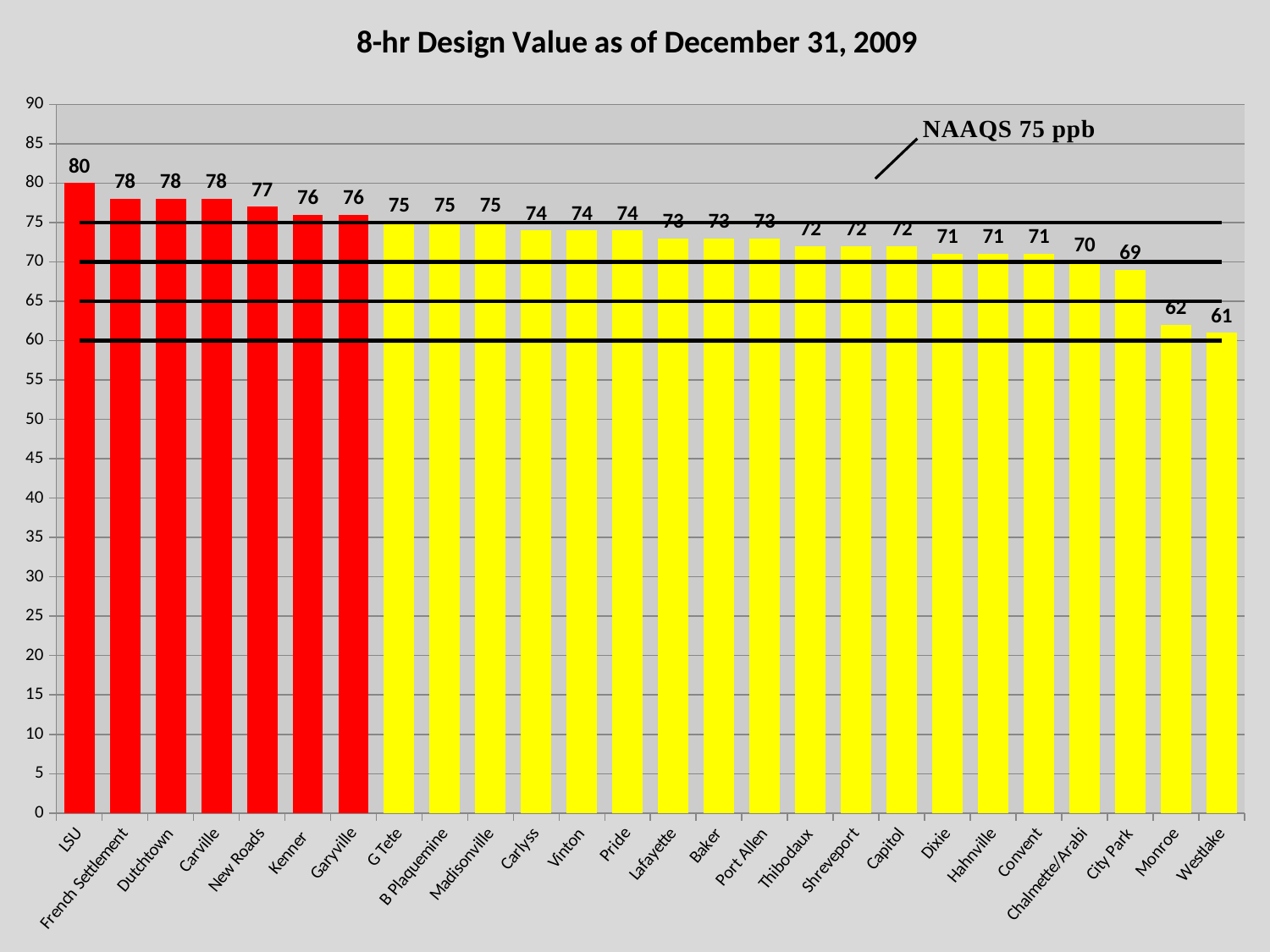
What standard value is labelled by the annotation on the chart? NAAQS 75 ppb What is the difference between the design values for New Roads and City Park? 8 How many sites are shown on the chart? 26 What kind of chart is shown on the slide? Bar chart Do the design values rise or fall moving from left to right across the sites? Fall Which has a higher design value, Kenner or Shreveport? Kenner Which site has the lowest 8-hr design value? Westlake What is the difference between the design values for LSU and Westlake? 19 Which site has the highest 8-hr design value? LSU What is the 8-hr design value for LSU? 80 What is the 8-hr design value for Monroe? 62 What is the 8-hr design value for Chalmette/Arabi? 70